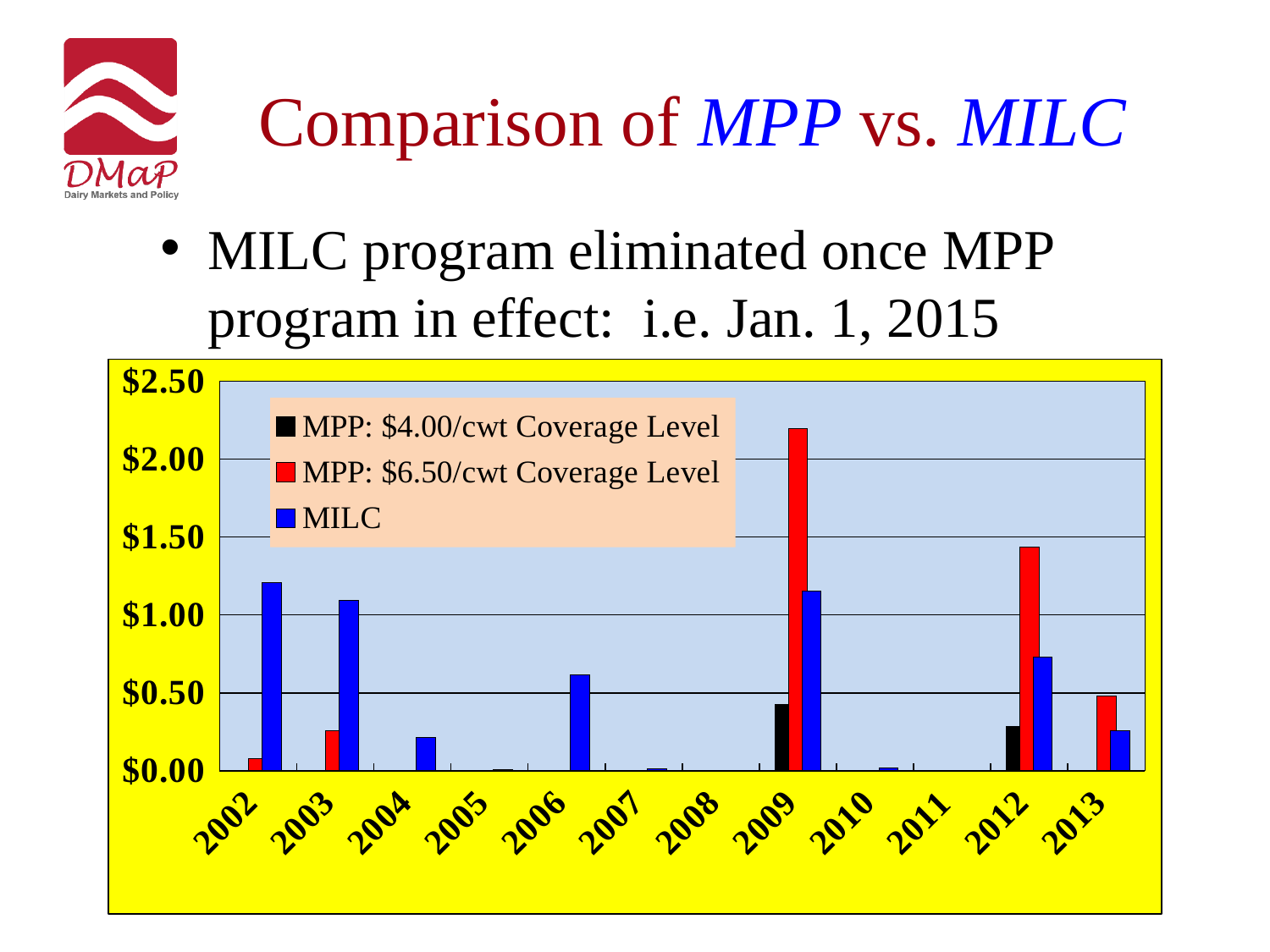
Is the MILC value for 2006 greater or less than $0.50? greater In 2002, which is larger: the MILC value or the MPP: $6.50/cwt Coverage Level value? MILC Is the MILC value for 2002 greater or less than $1.00? greater Is the MPP: $6.50/cwt Coverage Level value for 2012 greater or less than $1.00? greater In which year is the MPP: $6.50/cwt Coverage Level value highest? 2009 How many years are shown on the x axis? 12 In 2009, which is larger: the MPP: $6.50/cwt Coverage Level value or the MILC value? MPP: $6.50/cwt Coverage Level How many series does the legend list? 3 What colour represents the MILC series in the chart? blue What kind of chart is shown on the slide? bar chart